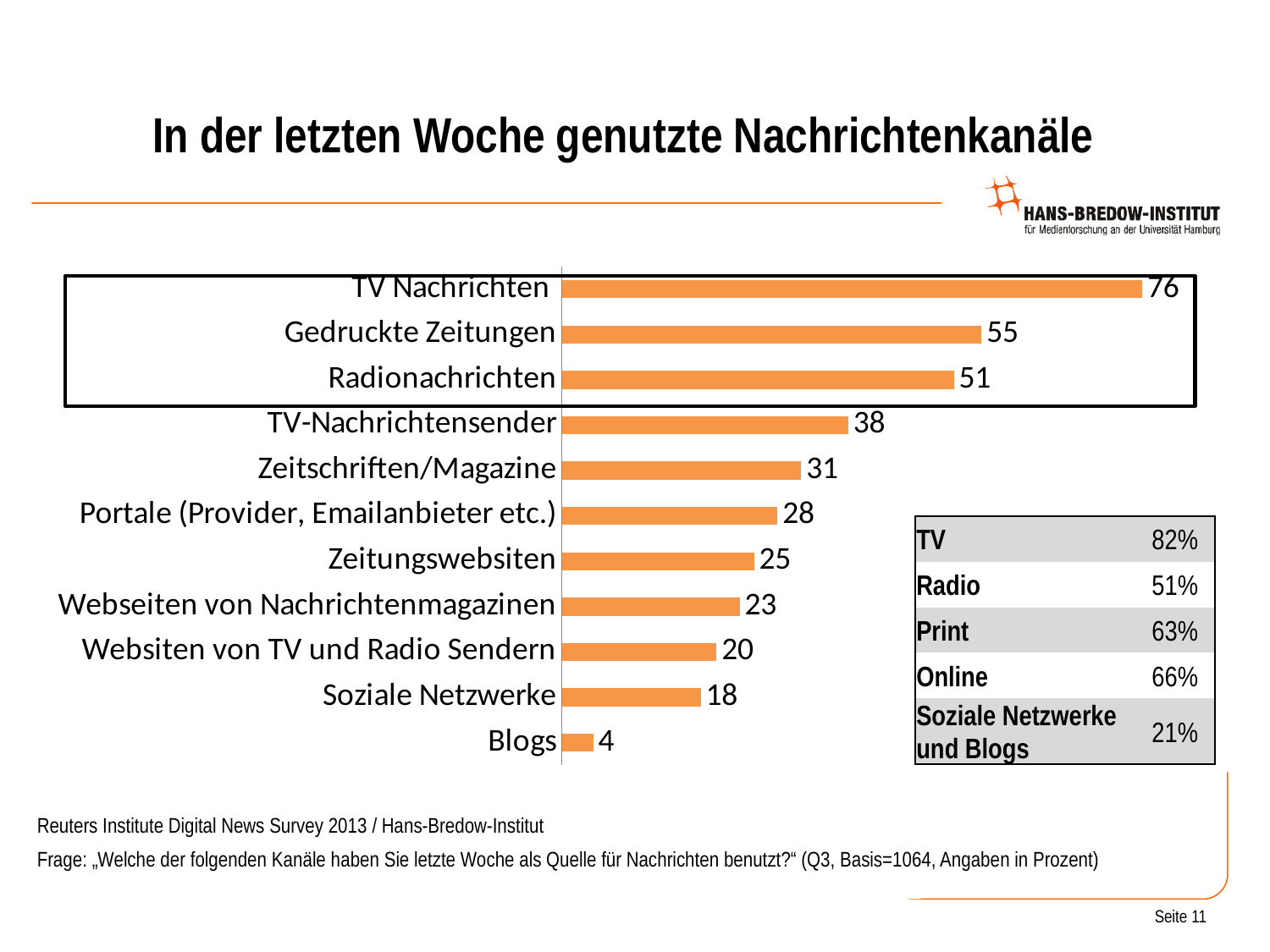
How many categories are shown in the chart? 11 Which category has the highest value? TV Nachrichten What is the value for TV Nachrichten? 76 What is the value for Websiten von TV und Radio Sendern? 20 What is the difference between the values for Gedruckte Zeitungen and Radionachrichten? 4 What is the difference between the values for Zeitungswebsiten and Webseiten von Nachrichtenmagazinen? 2 What kind of chart is shown on the slide? bar chart Which category has the lowest value? Blogs What is the value for Soziale Netzwerke? 18 What is the title of the slide containing the chart? In der letzten Woche genutzte Nachrichtenkanäle Which is larger, the value for Zeitschriften/Magazine or the value for TV-Nachrichtensender? TV-Nachrichtensender What is the value for Portale (Provider, Emailanbieter etc.)? 28